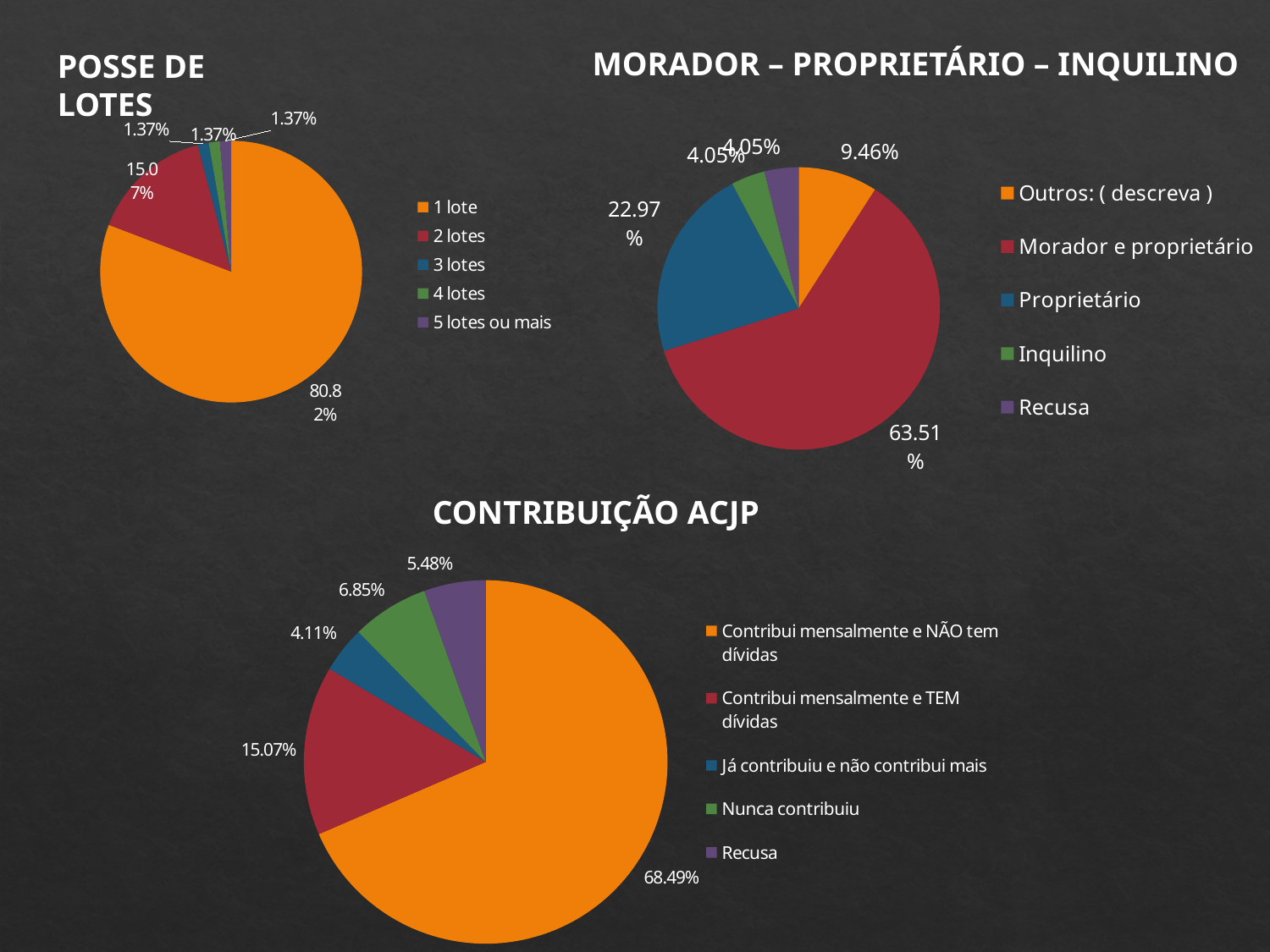
In the POSSE DE LOTES chart, what share of the pie is '1 lote'? 80.82% In the POSSE DE LOTES chart, how many categories does the legend list? 5 In the MORADOR – PROPRIETÁRIO – INQUILINO chart, what is the difference between 'Morador e proprietário' and 'Proprietário'? 40.54% In the MORADOR – PROPRIETÁRIO – INQUILINO chart, what is the value for 'Proprietário'? 22.97% In the CONTRIBUIÇÃO ACJP chart, what colour is the 'Contribui mensalmente e TEM dívidas' slice? Red In the POSSE DE LOTES chart, what is the value for '2 lotes'? 15.07% What kind of chart is the CONTRIBUIÇÃO ACJP chart? Pie chart In the CONTRIBUIÇÃO ACJP chart, what is the value for 'Contribui mensalmente e NÃO tem dívidas'? 68.49% In the CONTRIBUIÇÃO ACJP chart, which is larger: 'Nunca contribuiu' or 'Recusa'? Nunca contribuiu In the MORADOR – PROPRIETÁRIO – INQUILINO chart, what is the value for 'Outros: ( descreva )'? 9.46% In the CONTRIBUIÇÃO ACJP chart, which category has the smallest slice? Já contribuiu e não contribui mais In the MORADOR – PROPRIETÁRIO – INQUILINO chart, which category has the largest slice? Morador e proprietário